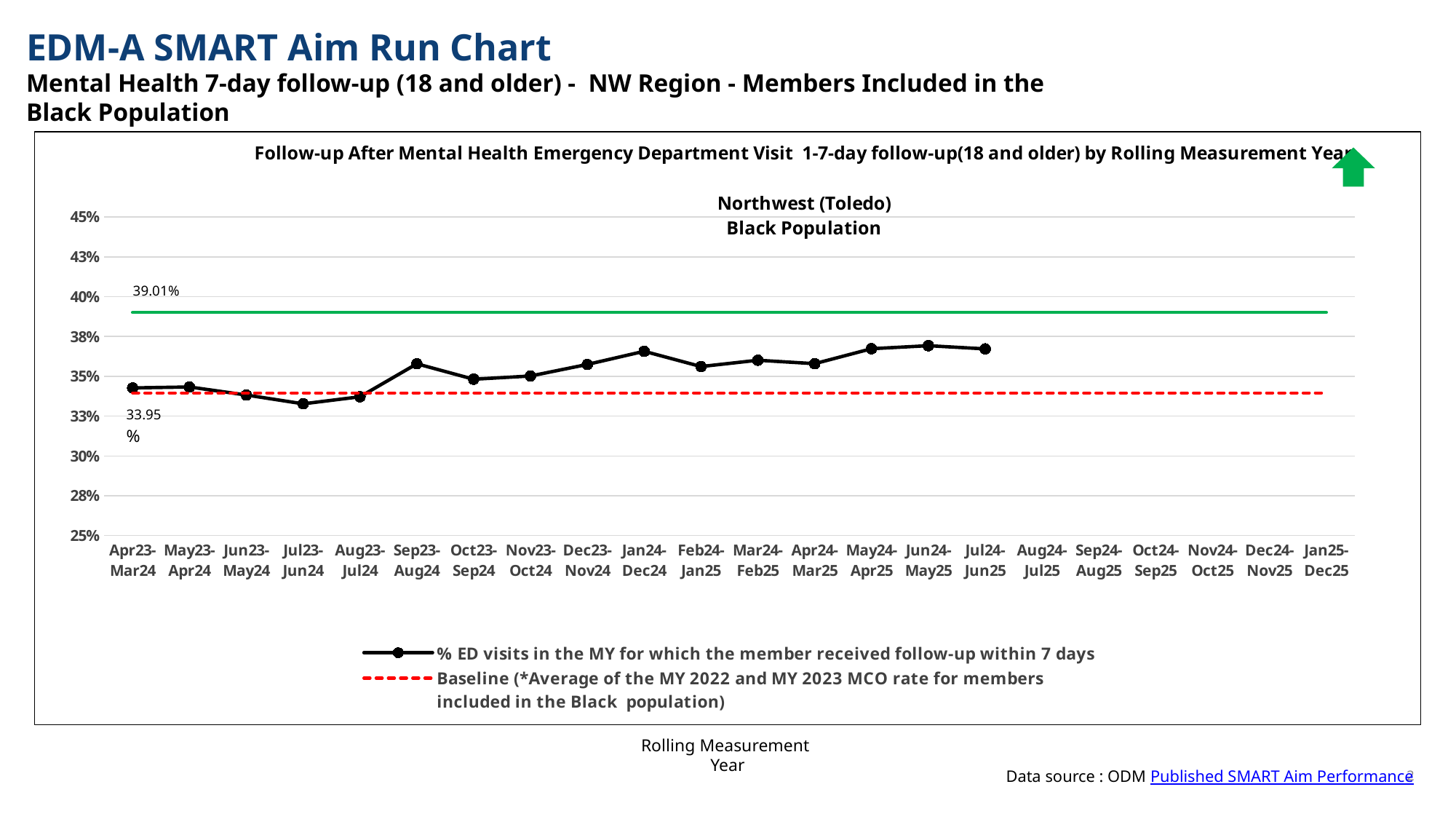
What is the difference between the green line value (39.01%) and the baseline value (33.95%)? 5.06 percentage points What kind of chart is shown on the slide? line chart How many data points are plotted on the black line? 16 Is the value for Jan24-Dec24 greater or less than 35%? greater What value is labelled on the solid green horizontal line? 39.01% Which is larger, the value for Sep23-Aug24 or the value for Oct23-Sep24? Sep23-Aug24 Which rolling measurement year has the lowest plotted value? Jul23-Jun24 What is the value of the baseline (red dashed line) shown on the chart? 33.95% How many rolling measurement year categories are shown on the x axis? 22 Do the plotted values generally rise or fall from Apr23-Mar24 to Jul24-Jun25? rise How many series does the legend list? 2 Is the value for Jul23-Jun24 greater or less than 35%? less